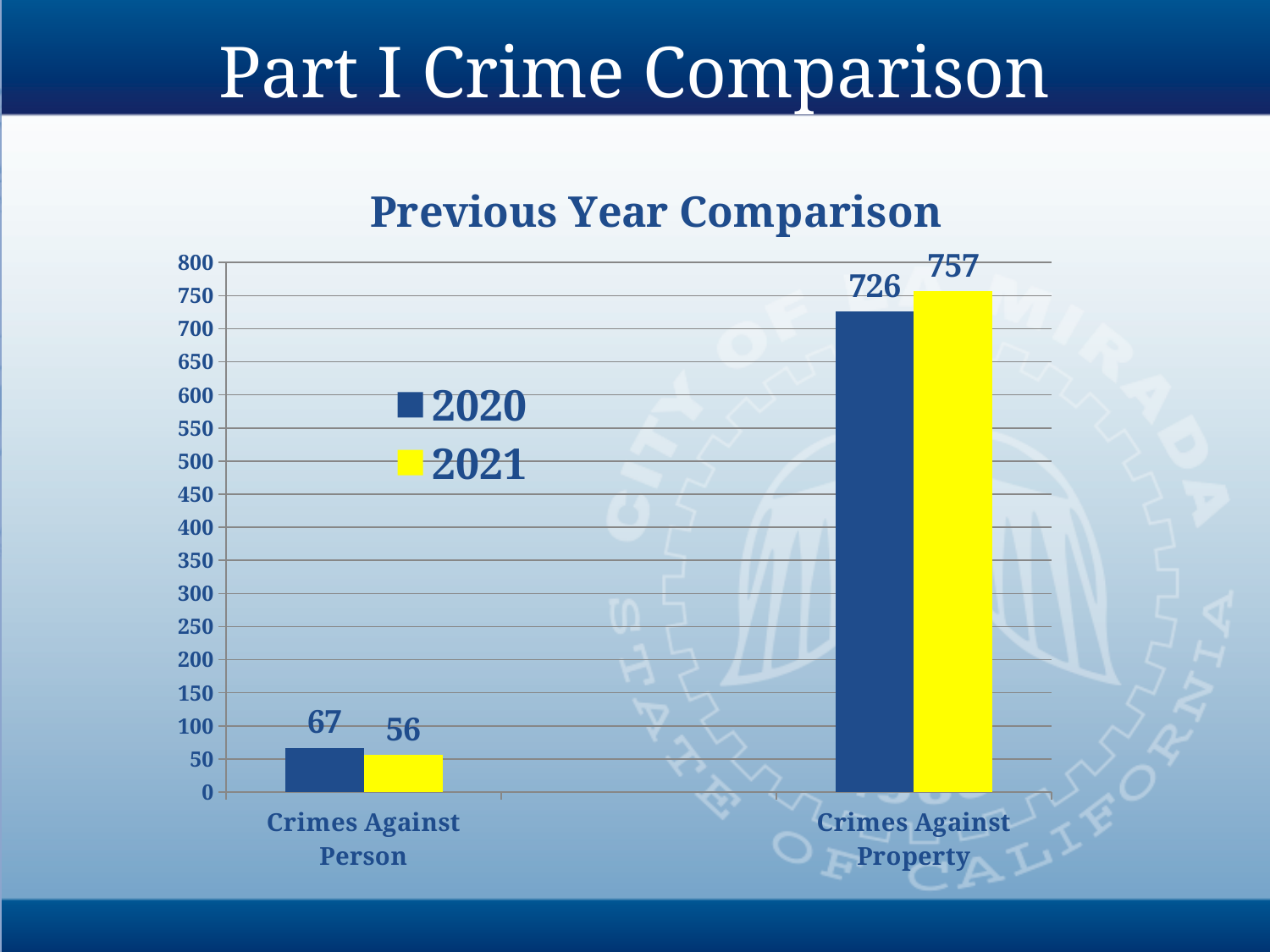
What is the difference between the 2021 and 2020 values for Crimes Against Property? 31 How many series does the legend list? 2 For Crimes Against Person, which year has the larger value, 2020 or 2021? 2020 What is the 2021 value for Crimes Against Person? 56 How many categories are shown on the x axis? 2 What is the 2020 value for Crimes Against Property? 726 What is the 2020 value for Crimes Against Person? 67 What is the difference between the 2020 and 2021 values for Crimes Against Person? 11 Which category has the highest 2021 value? Crimes Against Property What type of chart is shown on the slide? Bar chart Which category has the lowest 2020 value? Crimes Against Person What is the 2021 value for Crimes Against Property? 757